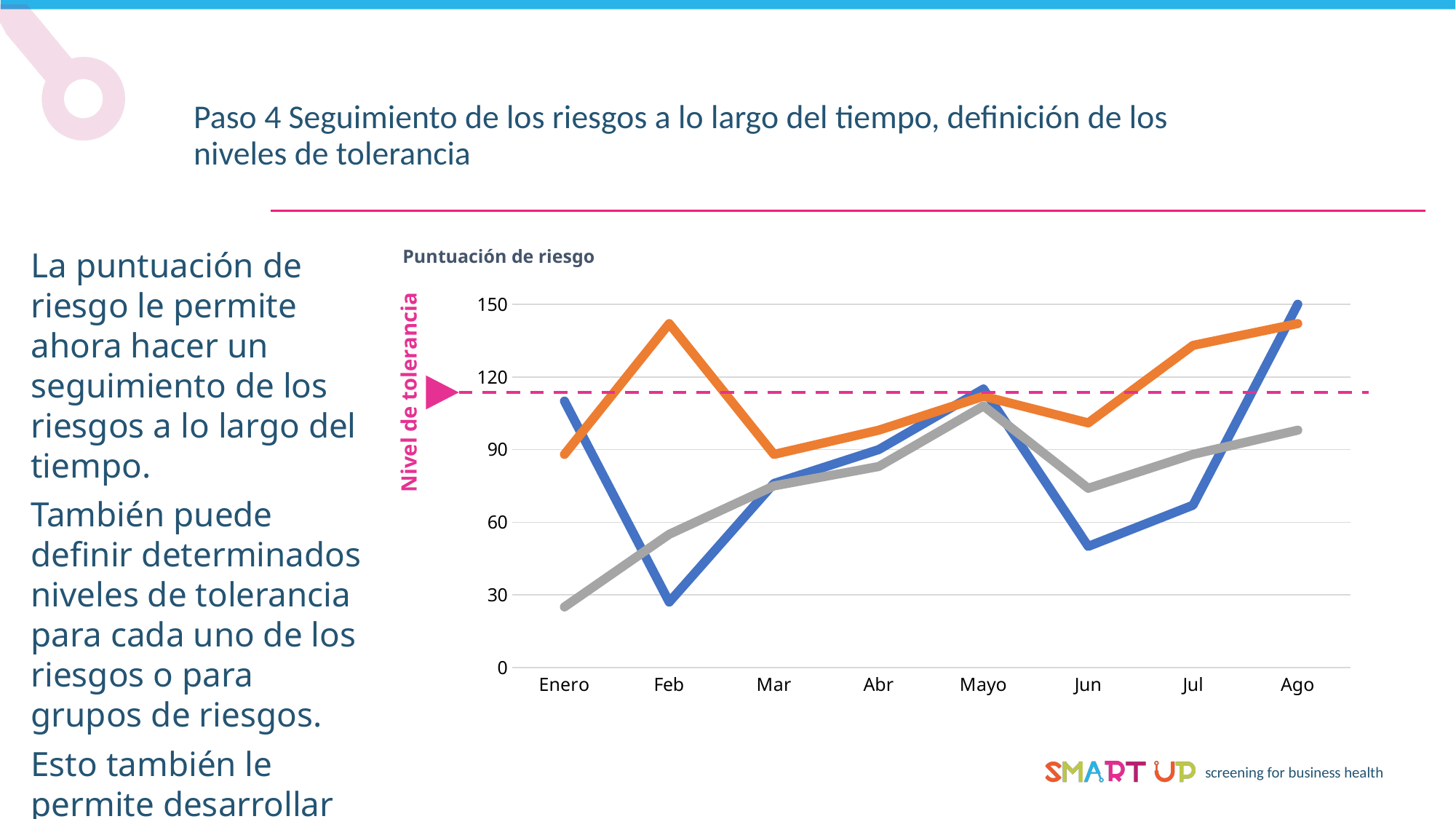
Is the value of the grey line in Jun greater or less than 90? less Is the value of the orange line in Feb greater or less than 120? greater How many months are shown on the x axis of the chart? 8 In Jun, which line has the higher value, the blue line or the orange line? orange line Is the value of the blue line in Ago greater or less than 120? greater In which month does the grey line reach its lowest value? Enero What is the title of the chart? Puntuación de riesgo How many lines are plotted on the chart (excluding the dashed tolerance line)? 3 What kind of chart is shown on the slide? line chart In which month does the blue line reach its lowest value? Feb What is the label of the dashed horizontal line on the chart? Nivel de tolerancia